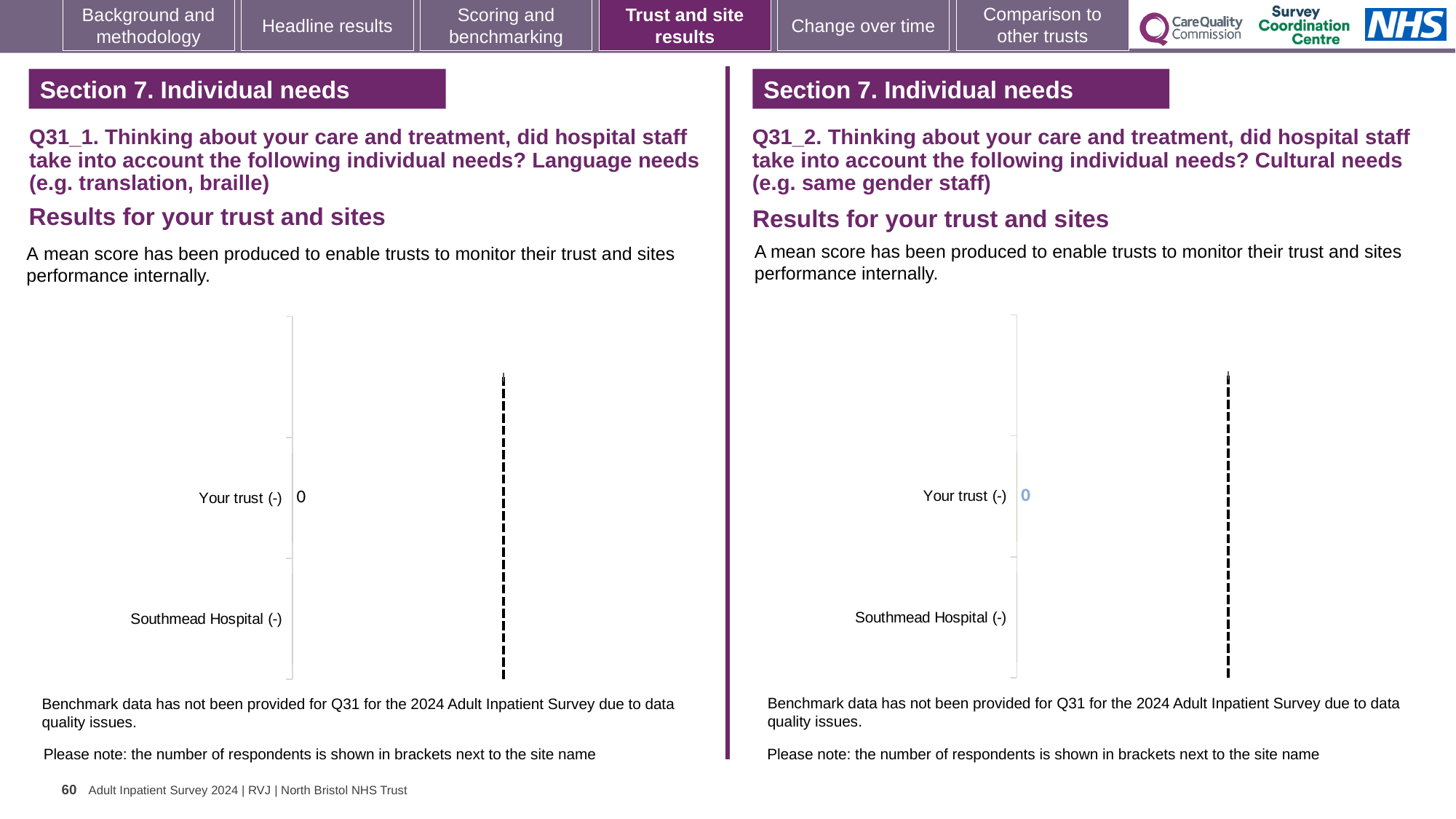
On the left chart (Q31_1, Language needs), what is the label of the category below Your trust (-)? Southmead Hospital (-) On the right chart (Q31_2, Cultural needs), what is the label of the first category on the vertical axis? Your trust (-) On the left chart (Q31_1, Language needs), what value is shown for Your trust (-)? 0 On the right chart (Q31_2, Cultural needs), what value is shown for Your trust (-)? 0 On the left chart (Q31_1, Language needs), how many categories are listed on the vertical axis? 2 On the right chart (Q31_2, Cultural needs), how many categories are listed on the vertical axis? 2